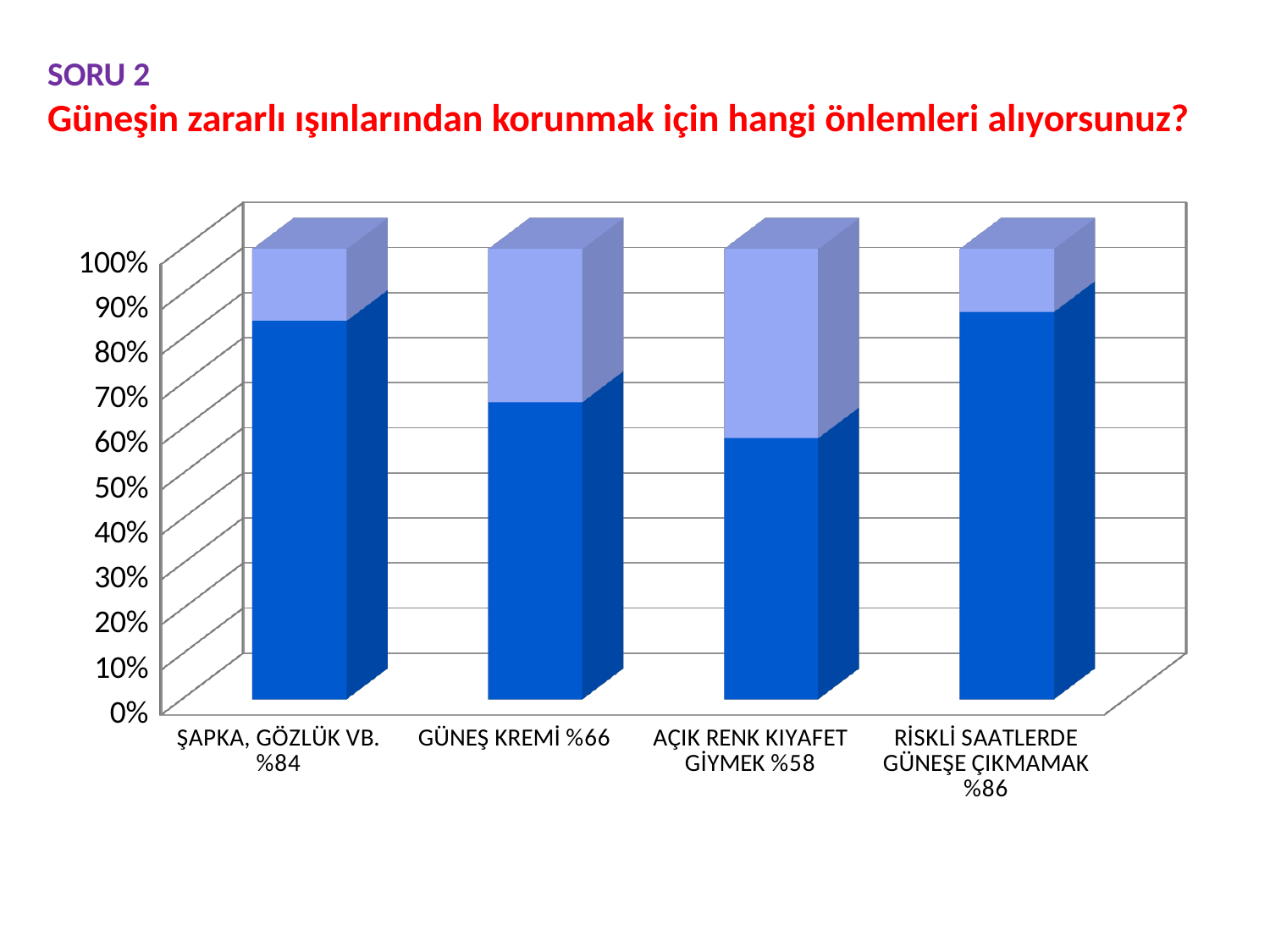
How many categories are shown on the x axis? 4 What percentage is shown for AÇIK RENK KIYAFET GİYMEK? %58 Which category has the highest percentage? RİSKLİ SAATLERDE GÜNEŞE ÇIKMAMAK What is the difference between the percentages for RİSKLİ SAATLERDE GÜNEŞE ÇIKMAMAK and AÇIK RENK KIYAFET GİYMEK? 28 Is the dark blue value for GÜNEŞ KREMİ greater or less than 50%? greater Which category has the lowest percentage? AÇIK RENK KIYAFET GİYMEK What is the difference between the percentages for ŞAPKA, GÖZLÜK VB. and GÜNEŞ KREMİ? 18 What percentage is shown for ŞAPKA, GÖZLÜK VB.? %84 Which is larger, the percentage for GÜNEŞ KREMİ or for AÇIK RENK KIYAFET GİYMEK? GÜNEŞ KREMİ What percentage is shown for RİSKLİ SAATLERDE GÜNEŞE ÇIKMAMAK? %86 What kind of chart is shown on the slide? Stacked bar chart What percentage is shown for GÜNEŞ KREMİ? %66